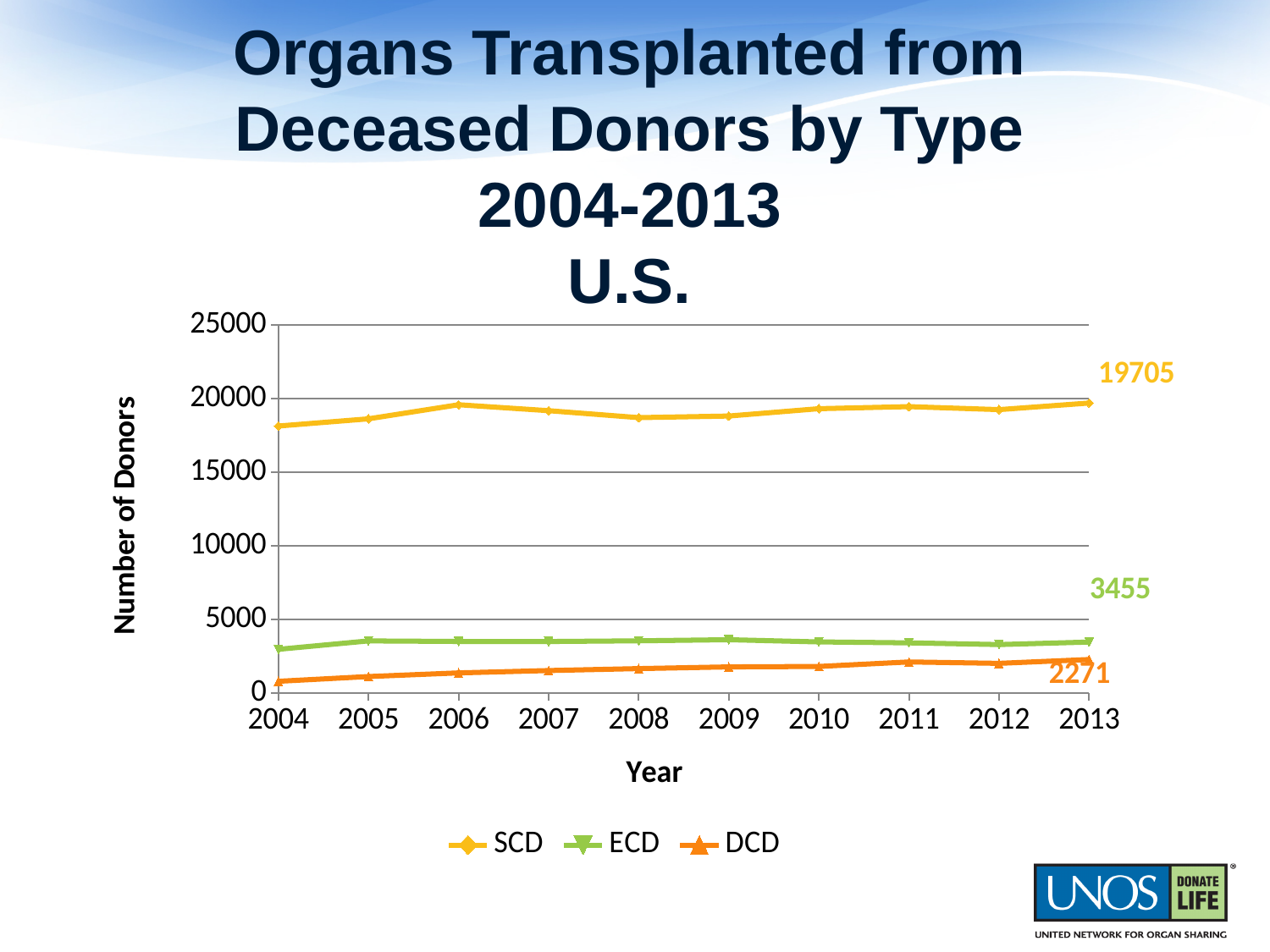
Which series has the highest value in 2013? SCD What is the value for ECD in 2013? 3455 Does the DCD series generally rise or fall from 2004 to 2013? Rise What is the difference between the ECD and DCD values in 2013? 1184 What is the difference between the SCD and ECD values in 2013? 16250 What is the value for SCD in 2013? 19705 Is the value for SCD in 2004 greater or less than 15000? greater What kind of chart is shown on the slide? Line chart What is the value for DCD in 2013? 2271 Which series has the lowest value in 2013? DCD How many series does the legend list? 3 Is the value for DCD in 2004 greater or less than 5000? less